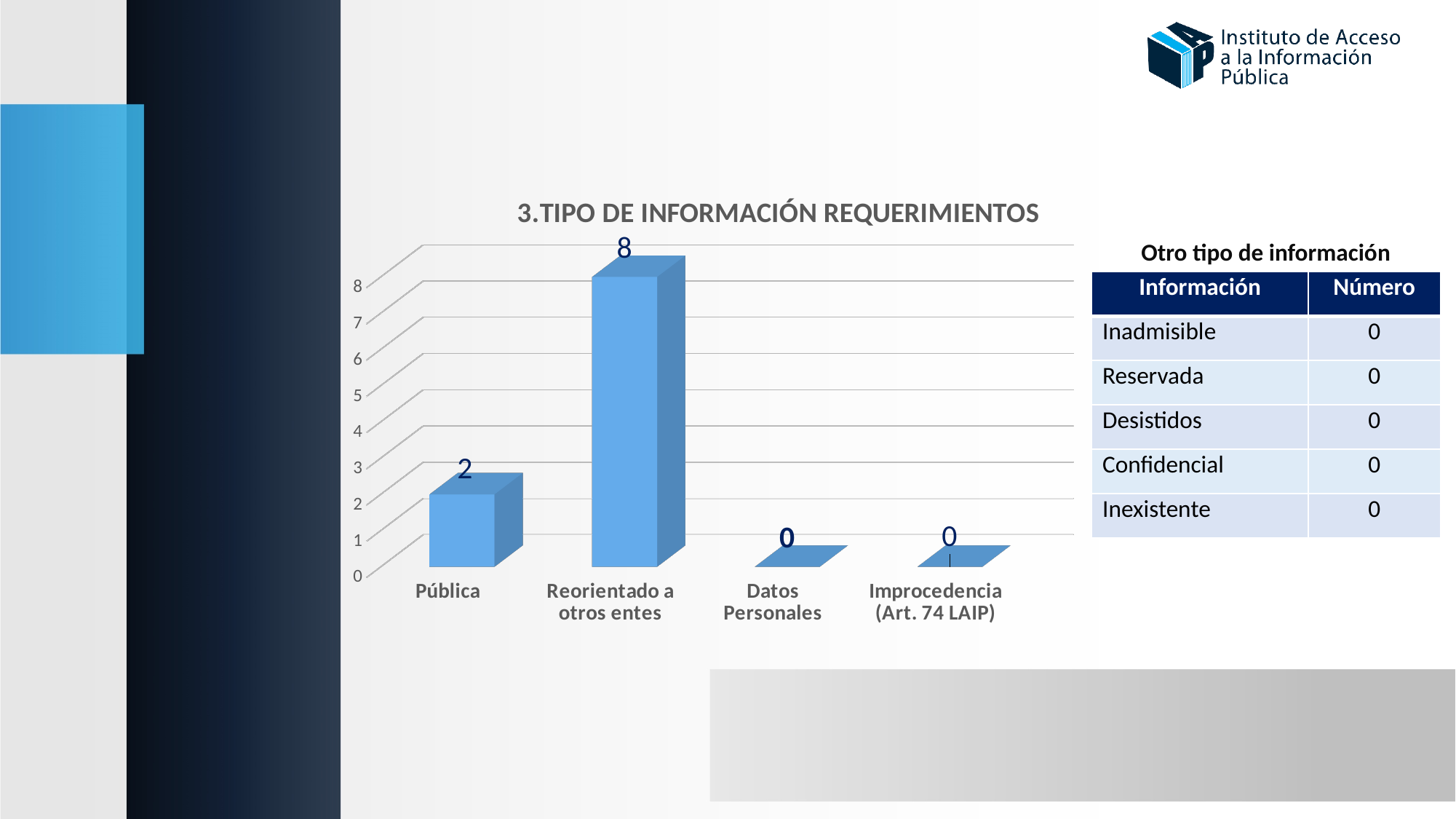
What is the value for Improcedencia (Art. 74 LAIP)? 0 What is the highest value shown on the chart's vertical axis? 8 What is the difference between the values for Reorientado a otros entes and Pública? 6 What is the title of the chart? 3.TIPO DE INFORMACIÓN REQUERIMIENTOS Is the value for Reorientado a otros entes greater or less than 5? greater What is the value for Reorientado a otros entes? 8 What kind of chart is shown on the slide? bar chart How many categories are shown on the x axis of the chart? 4 Which category has the highest value? Reorientado a otros entes Which is larger, the value for Pública or the value for Reorientado a otros entes? Reorientado a otros entes What is the value for Pública? 2 What is the value for Datos Personales? 0